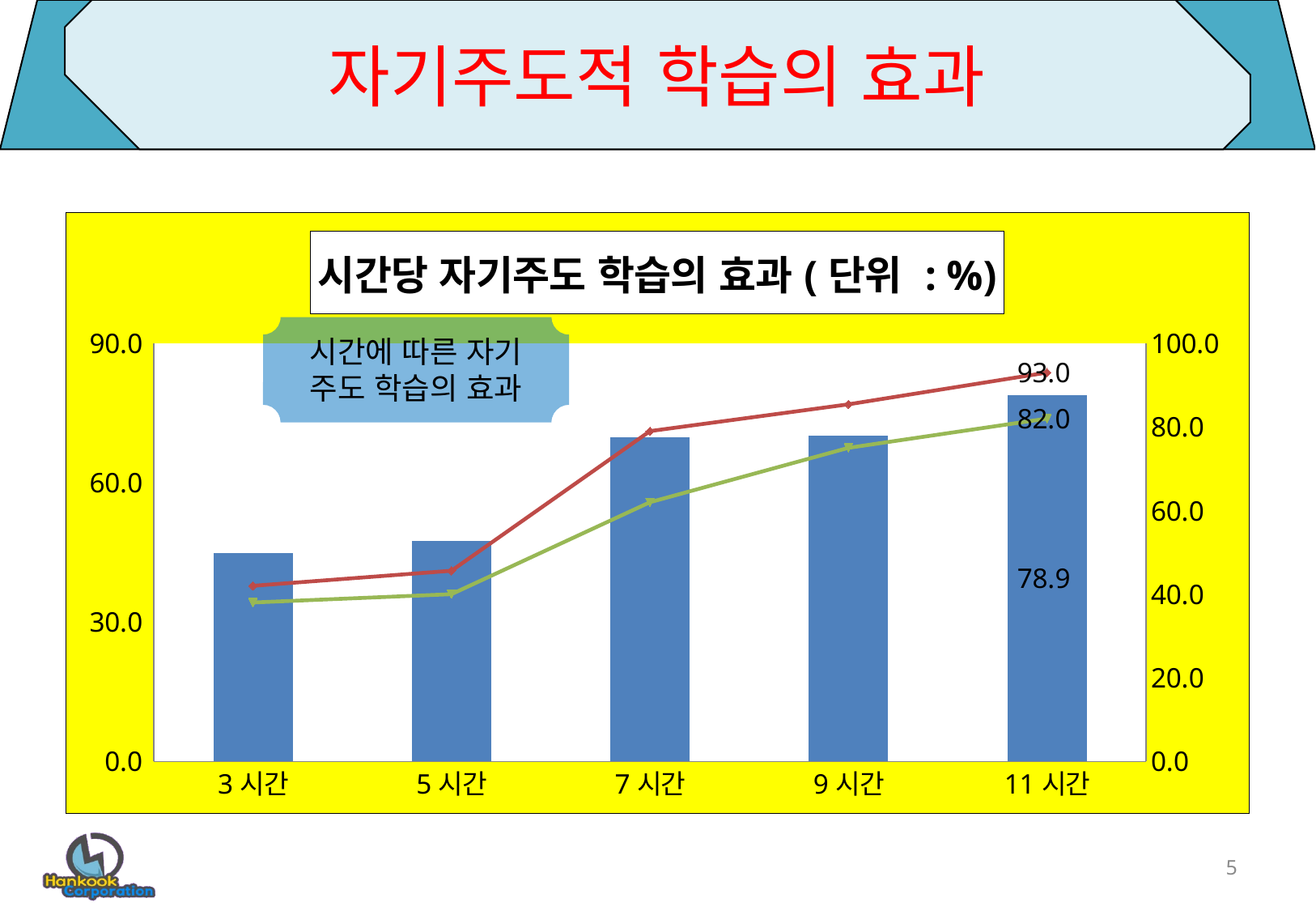
How many categories are shown on the x axis of the chart? 5 Is the bar for 7 시간 greater or less than 60.0 on the left axis? greater What is the value of the green line at 11 시간? 82.0 Which category has the shortest bar? 3 시간 Which category has the tallest bar? 11 시간 At 11 시간, what is the difference between the red line value and the green line value? 11.0 What is the value of the red line at 11 시간? 93.0 What is the title of the chart? 시간당 자기주도 학습의 효과 ( 단위 : %) What is the value of the bar for 11 시간? 78.9 What kind of chart is this? Combination bar and line chart Do the bar values generally rise or fall from 3 시간 to 11 시간? rise Is the bar for 3 시간 greater or less than 60.0 on the left axis? less